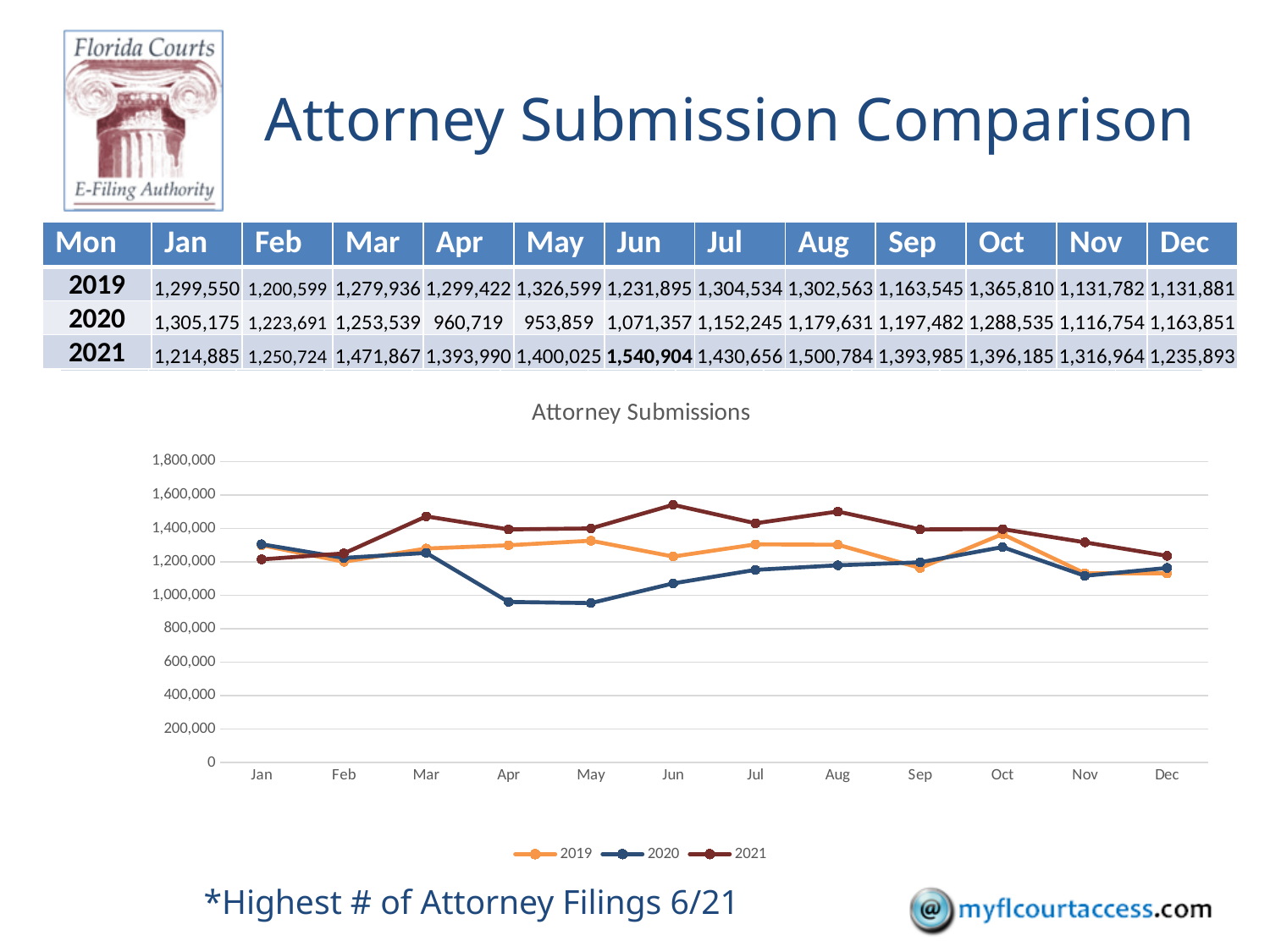
Is the value for May 2020 greater or less than 1,000,000? less How many series does the chart legend list? 3 What is the difference between the June 2021 and June 2020 attorney submissions? 469,547 Does the 2020 series rise or fall from March to May? fall What type of chart is shown on the slide? line chart How many months are plotted along the x axis of the chart? 12 What was the number of attorney submissions in October 2019? 1,365,810 What was the number of attorney submissions in June 2021? 1,540,904 In which month did the 2020 series reach its lowest value? May In which month did the 2021 series reach its highest value? Jun What was the number of attorney submissions in April 2020? 960,719 Which was larger, attorney submissions in March 2021 or March 2019? March 2021